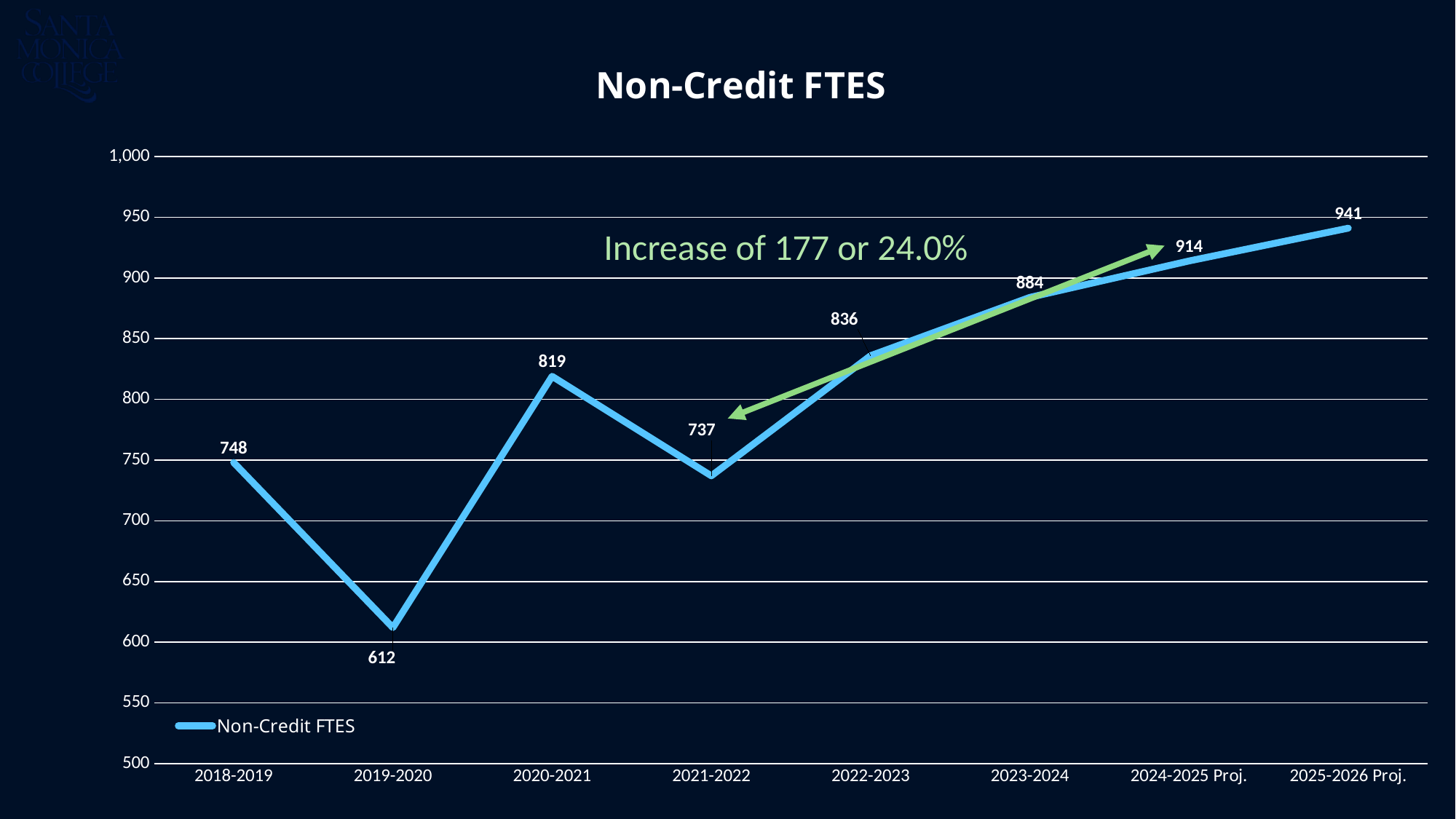
Which year has the lowest Non-Credit FTES value? 2019-2020 What is the difference between the Non-Credit FTES values for 2020-2021 and 2019-2020? 207 What is the projected Non-Credit FTES value for 2025-2026? 941 What kind of chart is shown on the slide? line chart Do the Non-Credit FTES values rise or fall from 2021-2022 to 2025-2026 Proj.? rise What is the Non-Credit FTES value for 2021-2022? 737 Which is larger, the Non-Credit FTES value for 2020-2021 or for 2021-2022? 2020-2021 What is the difference between the Non-Credit FTES values for 2024-2025 Proj. and 2023-2024? 30 What is the Non-Credit FTES value for 2018-2019? 748 Is the Non-Credit FTES value for 2022-2023 greater or less than 800? greater Which year has the highest Non-Credit FTES value? 2025-2026 Proj. How many years are plotted on the x axis? 8